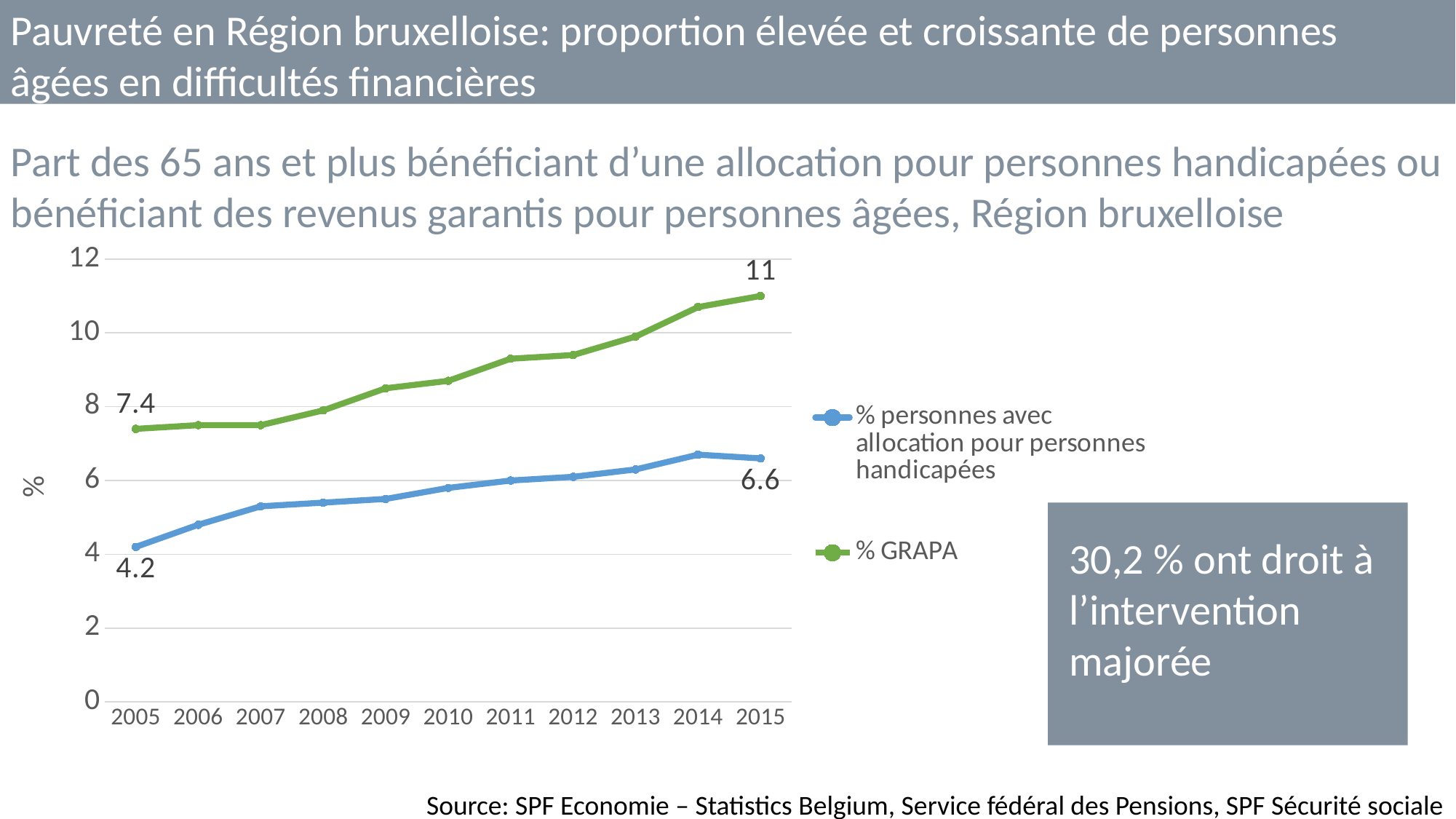
What is the value of % GRAPA in 2015? 11 What is the value of % GRAPA in 2005? 7.4 By how much did % GRAPA increase between 2005 and 2015? 3.6 Is the value for % GRAPA in 2013 greater or less than 8? greater What kind of chart is shown on the slide? line chart What is the value of % personnes avec allocation pour personnes handicapées in 2015? 6.6 Which series has the higher value in 2015, % GRAPA or % personnes avec allocation pour personnes handicapées? % GRAPA How many series does the legend list? 2 What is the difference between % GRAPA and % personnes avec allocation pour personnes handicapées in 2015? 4.4 What is the value of % personnes avec allocation pour personnes handicapées in 2005? 4.2 How many years are shown on the x axis? 11 Does the % GRAPA series rise or fall from 2005 to 2015? rises